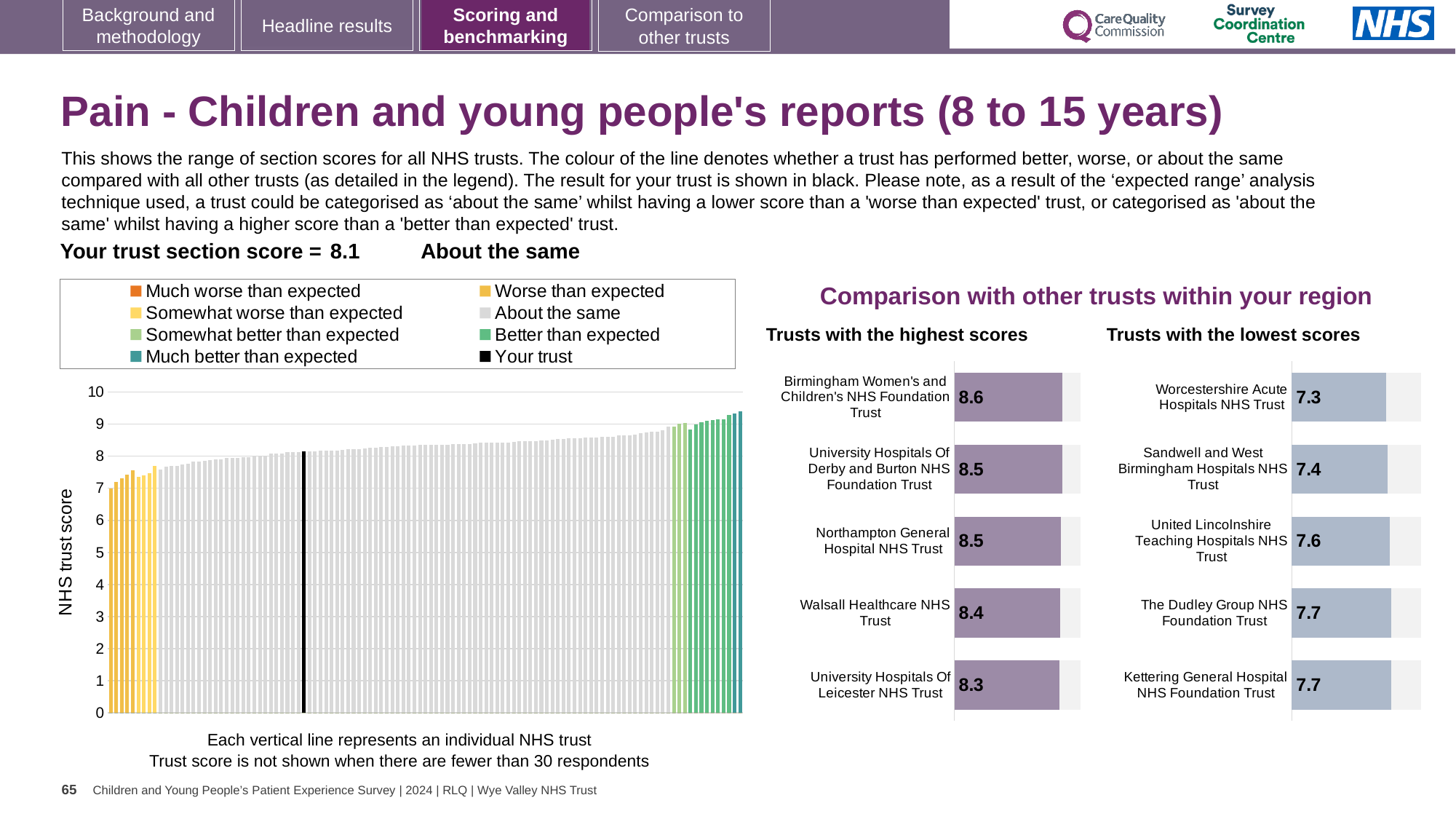
In the 'Trusts with the highest scores' chart, what is the score for Birmingham Women's and Children's NHS Foundation Trust? 8.6 In the 'Trusts with the lowest scores' chart, what is the score for Worcestershire Acute Hospitals NHS Trust? 7.3 In the main chart on the left showing all NHS trusts, what is the section score for your trust (the black line)? 8.1 In the 'Trusts with the lowest scores' chart, what is the difference between the scores of Kettering General Hospital NHS Foundation Trust and Worcestershire Acute Hospitals NHS Trust? 0.4 In the 'Trusts with the lowest scores' chart, what is the score for United Lincolnshire Teaching Hospitals NHS Trust? 7.6 In the 'Trusts with the lowest scores' chart, which trust has the lowest score? Worcestershire Acute Hospitals NHS Trust In the 'Trusts with the highest scores' chart, what is the difference between the scores of Birmingham Women's and Children's NHS Foundation Trust and University Hospitals Of Leicester NHS Trust? 0.3 In the 'Trusts with the highest scores' chart, how many trusts are shown? 5 In the 'Trusts with the lowest scores' chart, which has the larger score: The Dudley Group NHS Foundation Trust or Sandwell and West Birmingham Hospitals NHS Trust? The Dudley Group NHS Foundation Trust In the 'Trusts with the highest scores' chart, what is the score for Walsall Healthcare NHS Trust? 8.4 How many entries does the legend of the main chart on the left list? 8 In the 'Trusts with the highest scores' chart, which trust has the highest score? Birmingham Women's and Children's NHS Foundation Trust